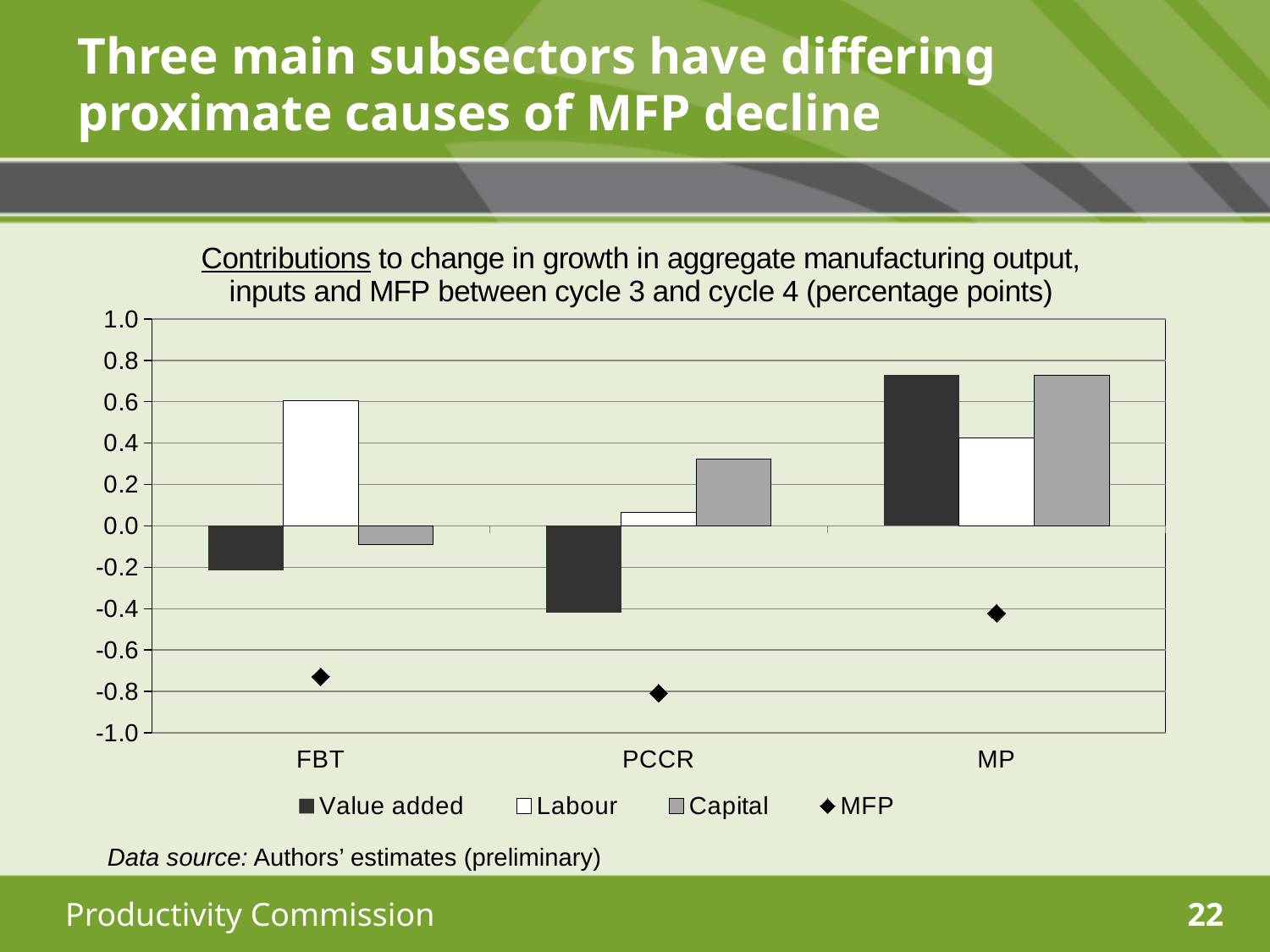
Is the Capital value for MP greater or less than 0.6? greater Is the Labour value for FBT greater or less than 0.4? greater Which subsector has the highest Value added contribution? MP Is the MFP value for PCCR greater or less than -0.6? less Which subsector has the highest Labour contribution? FBT Which series is plotted with diamond markers rather than bars? MFP How many series does the legend list? 4 What kind of chart is shown on the slide? combination bar and line chart (bars with diamond markers for MFP) How many subsector categories are shown on the x axis? 3 Which is larger, the Capital value for FBT or the Capital value for PCCR? PCCR